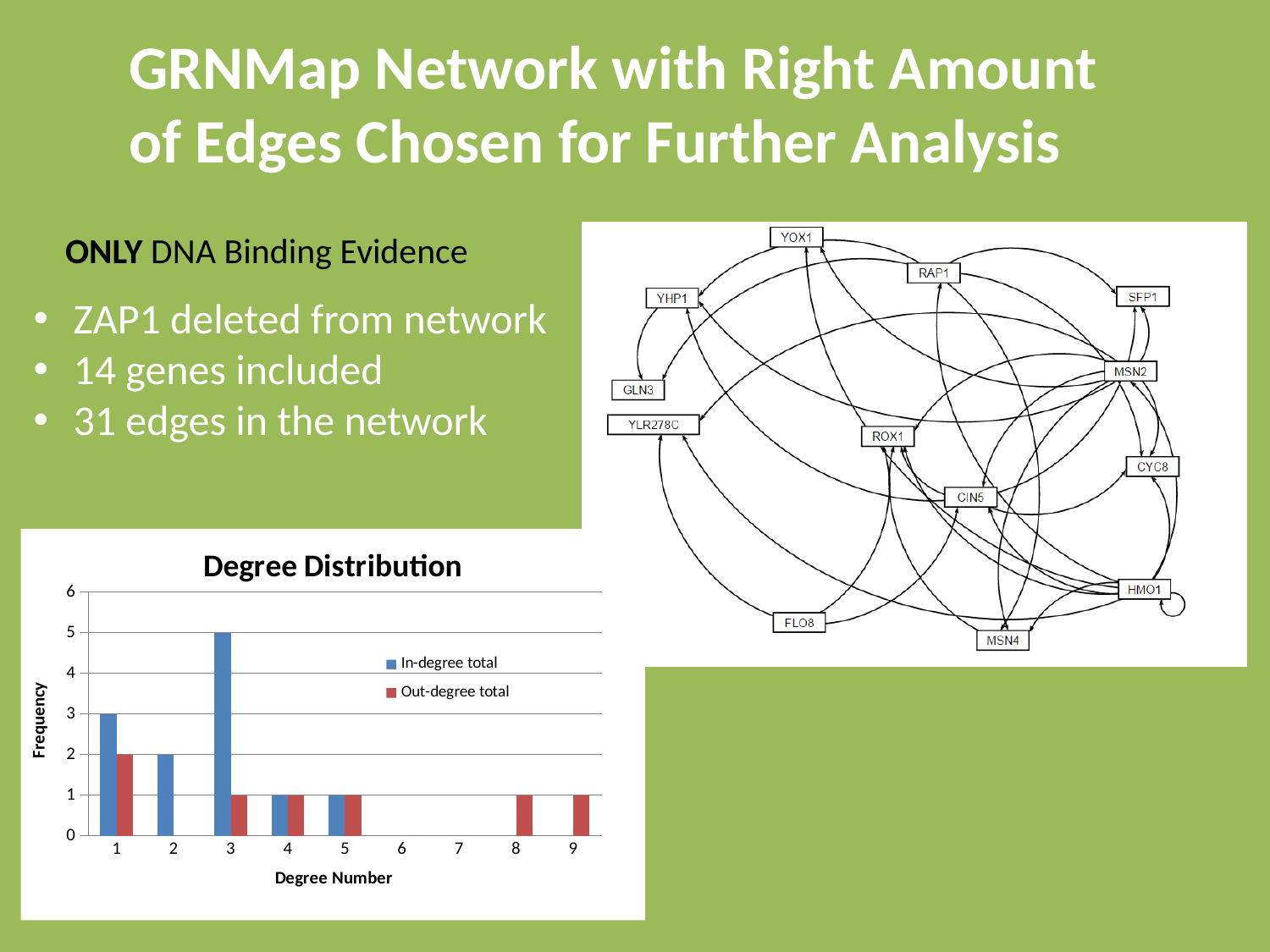
In the Degree Distribution chart, which is larger at degree number 1: the In-degree total or the Out-degree total? In-degree total How many series does the legend of the Degree Distribution chart list? 2 What is the label of the y axis on the Degree Distribution chart? Frequency How many degree number categories are shown on the x axis of the Degree Distribution chart? 9 In the Degree Distribution chart, what is the In-degree total frequency for degree number 1? 3 In the Degree Distribution chart, which degree number has the highest In-degree total frequency? 3 In the Degree Distribution chart, what is the Out-degree total frequency for degree number 9? 1 In the Degree Distribution chart, what is the In-degree total frequency for degree number 2? 2 In the Degree Distribution chart, what is the In-degree total frequency for degree number 3? 5 In the Degree Distribution chart, what is the Out-degree total frequency for degree number 1? 2 In the Degree Distribution chart, what is the difference between the In-degree total and Out-degree total frequencies at degree number 3? 4 What type of chart is the Degree Distribution chart? bar chart